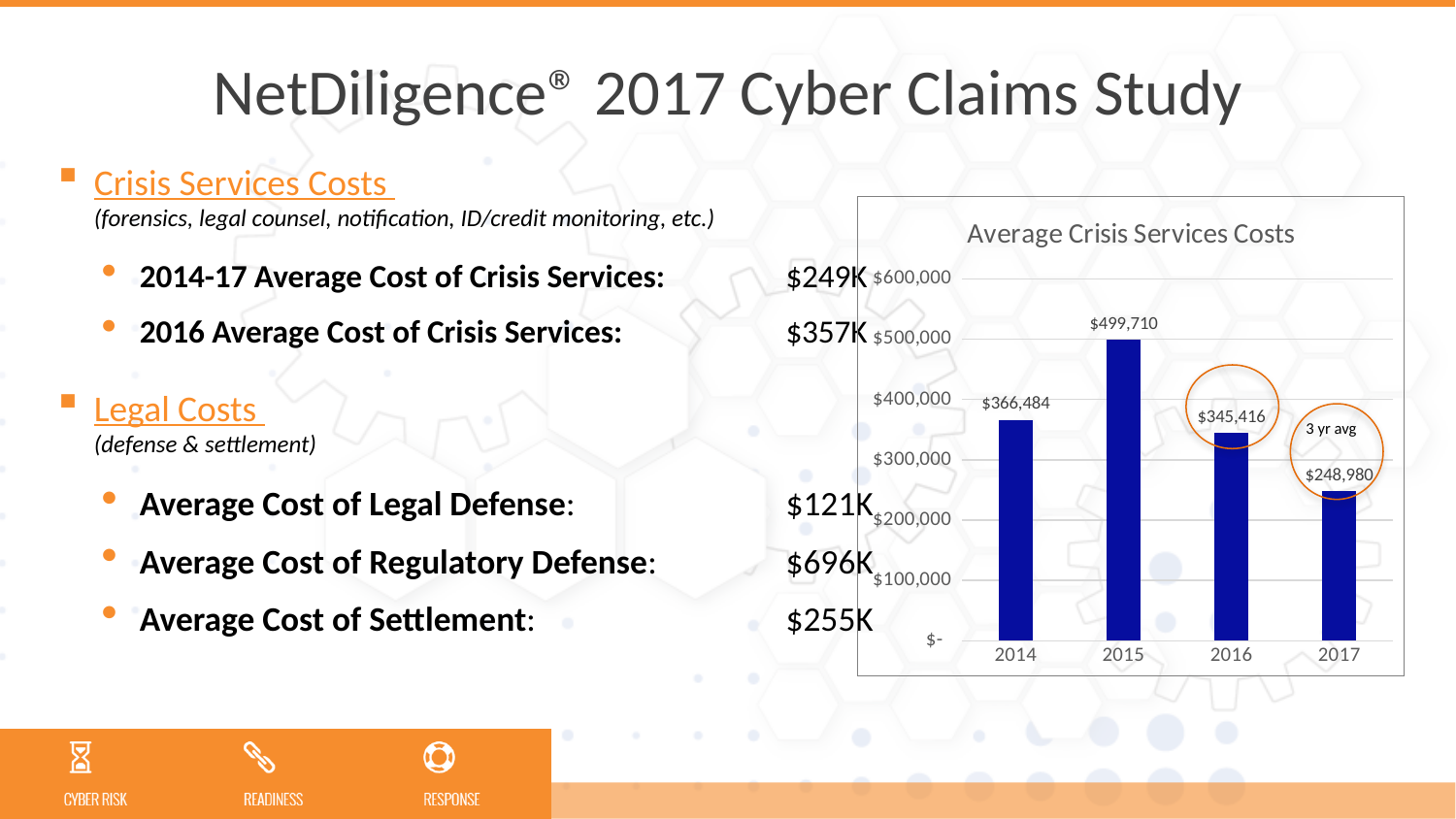
What is the value for 2017 in the Average Crisis Services Costs chart? $248,980 How many years are shown on the x axis of the Average Crisis Services Costs chart? 4 Which year has the lowest average crisis services cost in the chart? 2017 What is the value for 2014 in the Average Crisis Services Costs chart? $366,484 Is the value for 2016 in the Average Crisis Services Costs chart greater or less than $400,000? less Which is larger in the Average Crisis Services Costs chart, the value for 2014 or the value for 2016? 2014 What is the difference between the 2015 and 2016 values in the Average Crisis Services Costs chart? $154,294 What is the title of the chart on the slide? Average Crisis Services Costs Which year has the highest average crisis services cost in the chart? 2015 Do the values in the Average Crisis Services Costs chart rise or fall from 2015 to 2017? fall What is the value for 2015 in the Average Crisis Services Costs chart? $499,710 What kind of chart is the Average Crisis Services Costs chart? bar chart